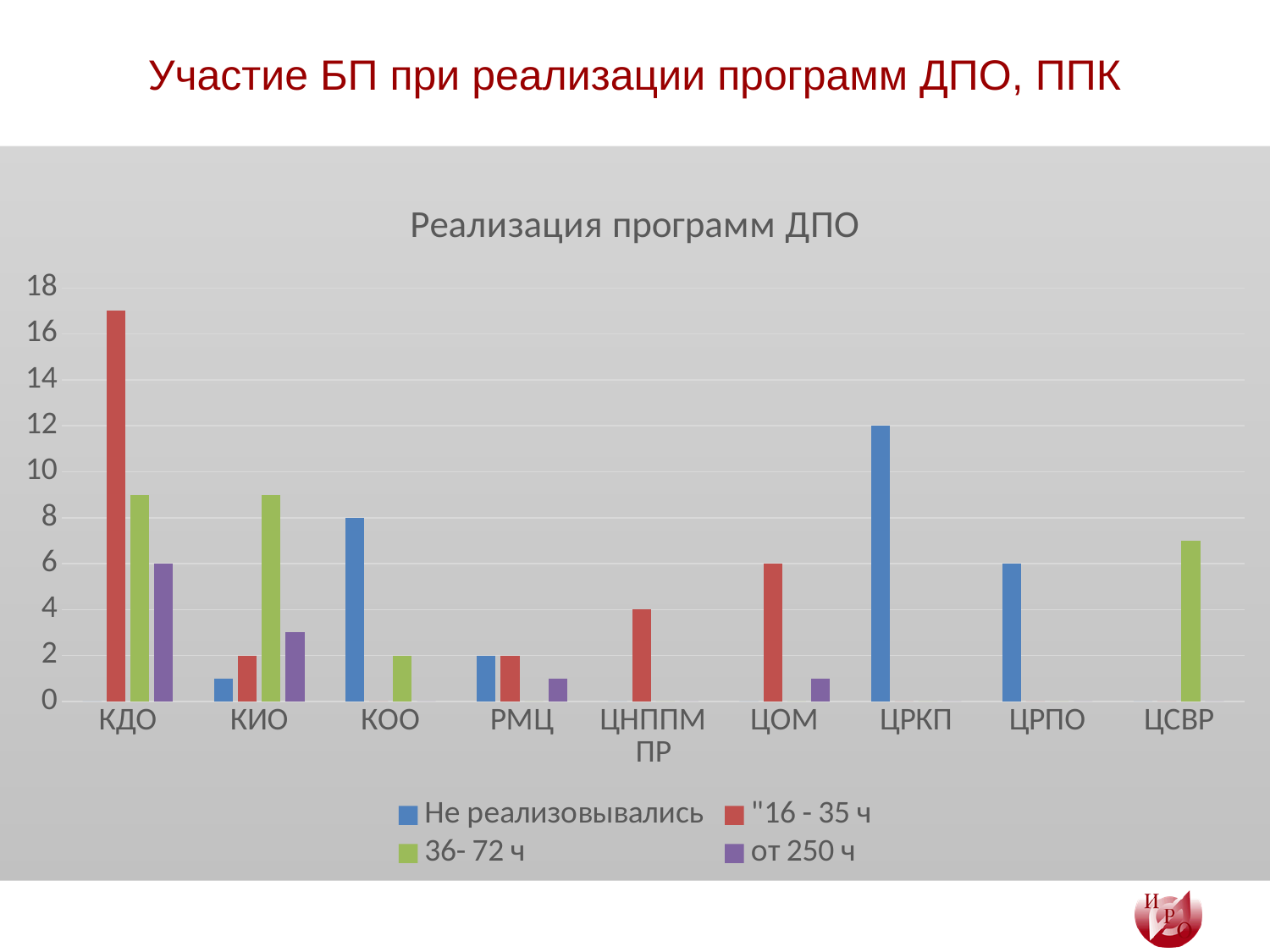
What is the value of the "Не реализовывались" series for КОО? 8 Which category has the tallest bar in the chart? КДО What is the value of the "от 250 ч" series for КДО? 6 Which is larger: the "Не реализовывались" value for ЦРКП or for ЦРПО? ЦРКП How many series does the legend list? 4 What is the value of the "16 - 35 ч" series for ЦНППМ ПР? 4 What is the value of the "16 - 35 ч" series for ЦОМ? 6 What kind of chart is shown on the slide? bar chart Is the value of the "36- 72 ч" series for ЦСВР greater or less than 8? less Is the value of the "16 - 35 ч" series for КДО greater or less than 16? greater How many categories are shown on the x axis? 9 What is the value of the "Не реализовывались" series for ЦРКП? 12